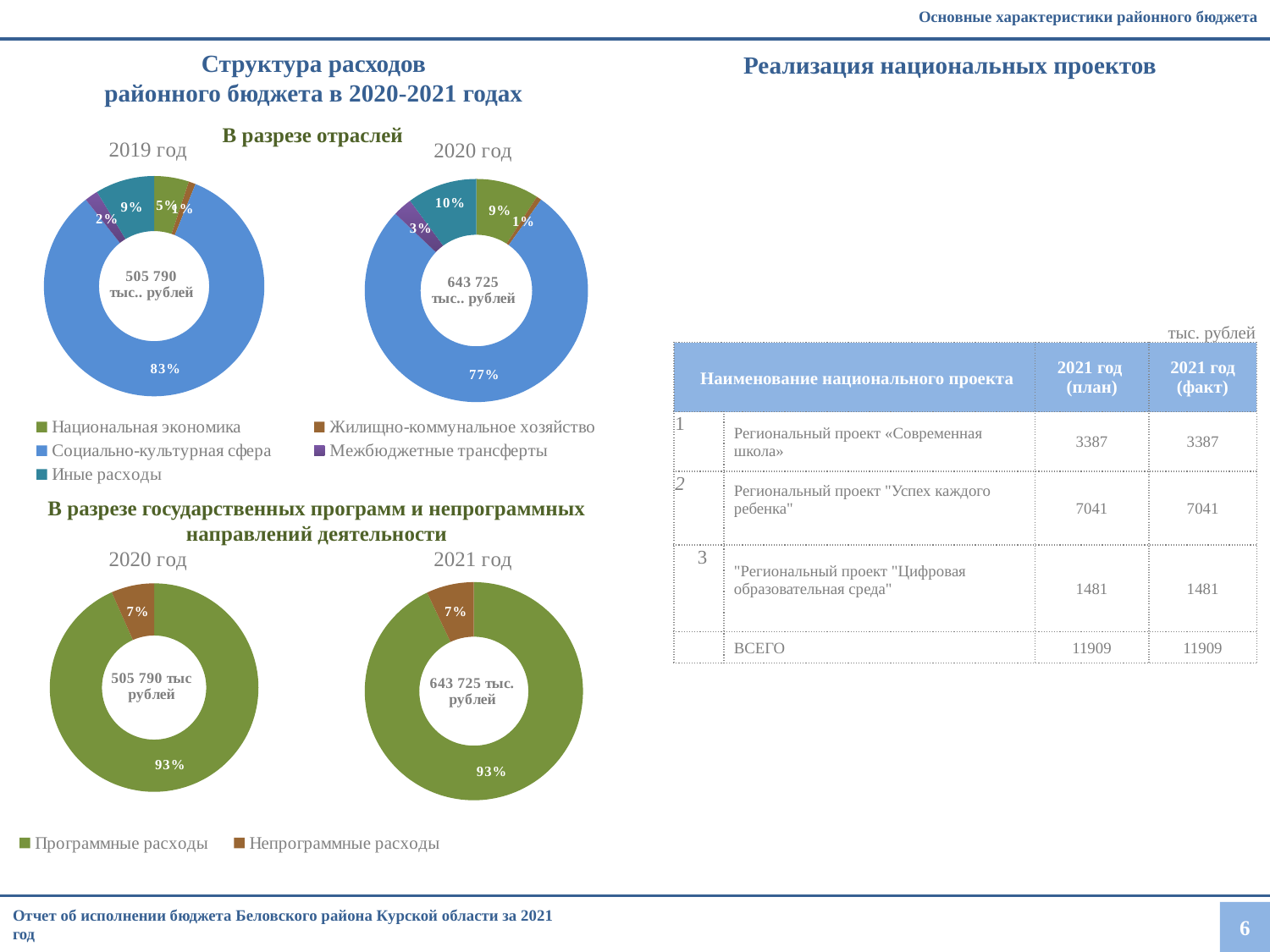
How many categories does the legend list for the 'В разрезе отраслей' donut charts? 5 In the '2019 год' donut chart under 'В разрезе отраслей', what share is shown for Национальная экономика (the green slice)? 5% In the '2019 год' donut chart under 'В разрезе отраслей', what share is shown for Социально-культурная сфера (the largest blue slice)? 83% In the '2021 год' donut chart under 'В разрезе государственных программ и непрограммных направлений деятельности', what share is shown for Программные расходы? 93% What total amount is printed in the centre of the '2020 год' donut chart under 'В разрезе отраслей'? 643 725 тыс.. рублей What total amount is printed in the centre of the '2019 год' donut chart under 'В разрезе отраслей'? 505 790 тыс.. рублей By how many percentage points does the share of Социально-культурная сфера in the '2019 год' chart exceed its share in the '2020 год' chart (В разрезе отраслей)? 6 What kind of chart is used to show the structure of expenditures on this slide? Pie (donut) chart In the '2020 год' donut chart under 'В разрезе отраслей', what share is shown for Иные расходы (the teal slice)? 10% In the '2020 год' donut chart under 'В разрезе государственных программ и непрограммных направлений деятельности', what share is shown for Непрограммные расходы? 7% In the '2019 год' donut chart under 'В разрезе отраслей', which category has the largest share? Социально-культурная сфера In the '2020 год' donut chart under 'В разрезе отраслей', what share is shown for Социально-культурная сфера (the largest blue slice)? 77%